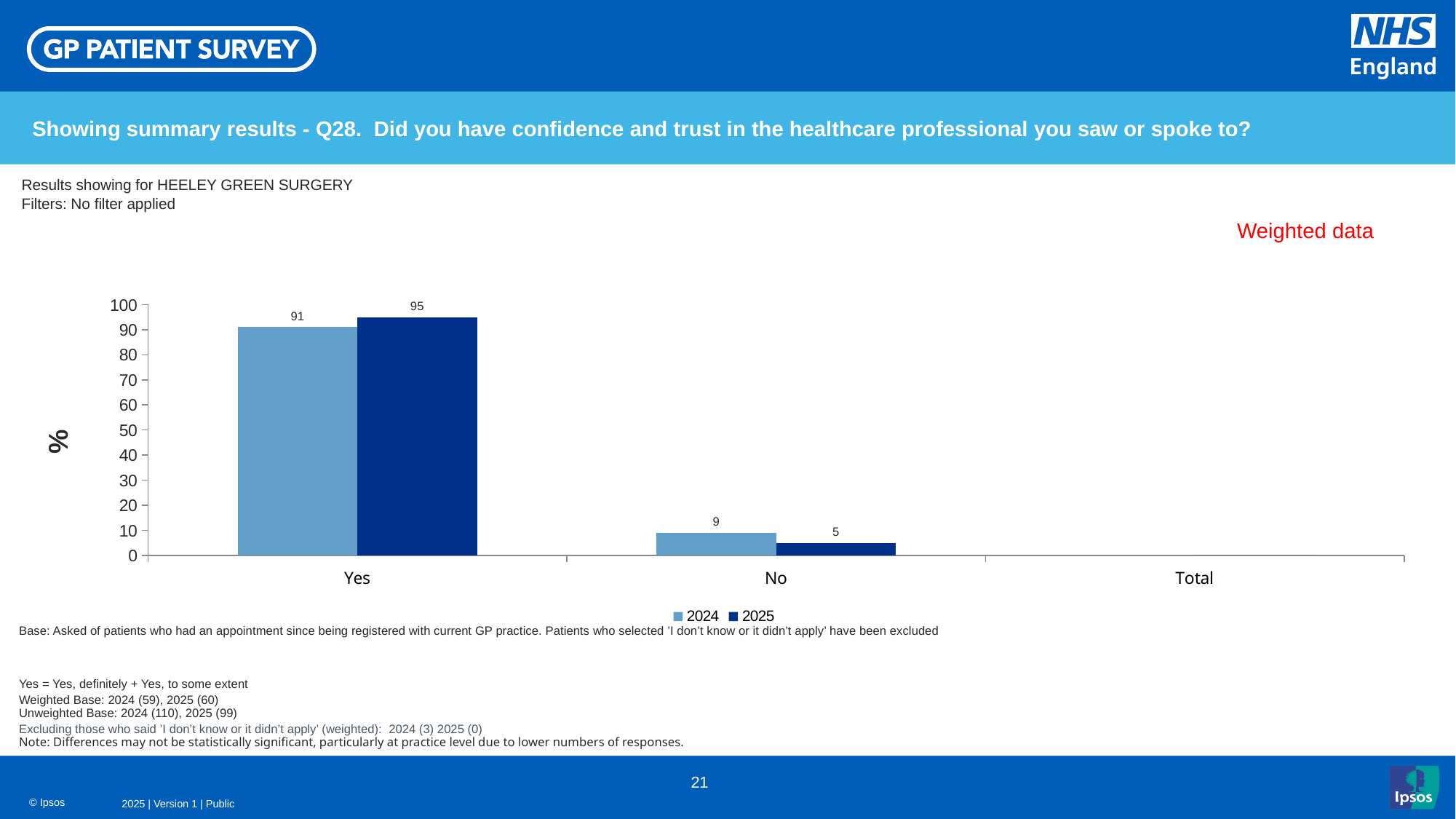
What kind of chart is shown on the slide? Bar chart Which category has the highest value in 2025? Yes What is the value for 'Yes' in 2024? 91 What is the value for 'No' in 2025? 5 Which is larger, the 2024 value for 'Yes' or the 2025 value for 'Yes'? 2025 What is the value for 'No' in 2024? 9 What is the difference between the 2025 and 2024 values for 'Yes'? 4 How many series does the legend list? 2 What is the difference between the 2024 and 2025 values for 'No'? 4 Is the 2025 value for 'Yes' greater or less than 90? greater What is the value for 'Yes' in 2025? 95 Which series is shown in the darker blue colour? 2025